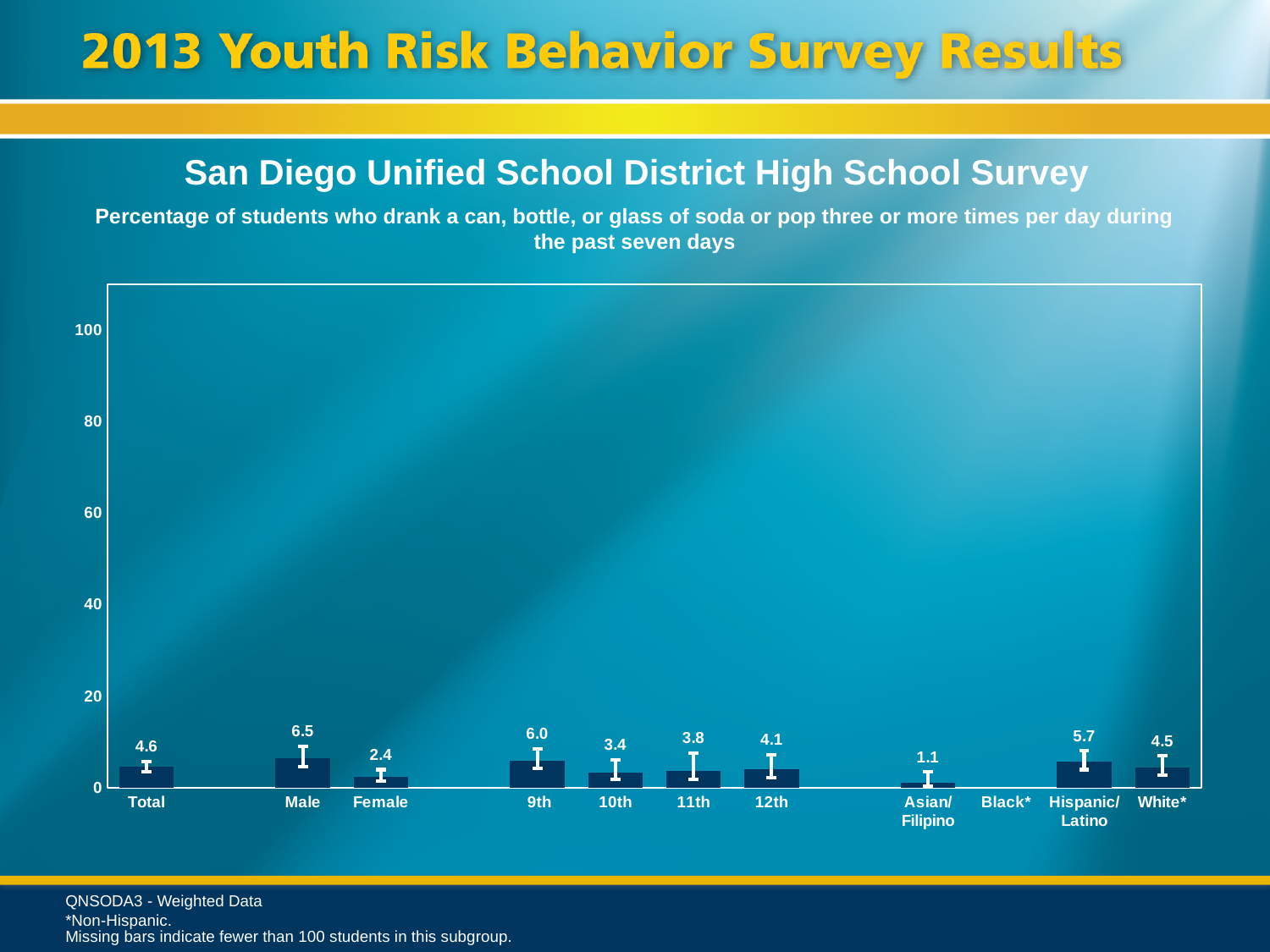
Which category label has no bar plotted? Black* What kind of chart is shown? bar chart What is the difference between the Male and Female values? 4.1 How many bars are plotted on the chart? 10 What is the value for Female? 2.4 Is the value for Total greater or less than 20? less What percentage is shown for Male? 6.5 Which category has the highest value? Male Which plotted category has the lowest value? Asian/Filipino What is the value for Asian/Filipino students? 1.1 What is the value for Hispanic/Latino students? 5.7 Which is larger, the value for 9th grade or 12th grade? 9th